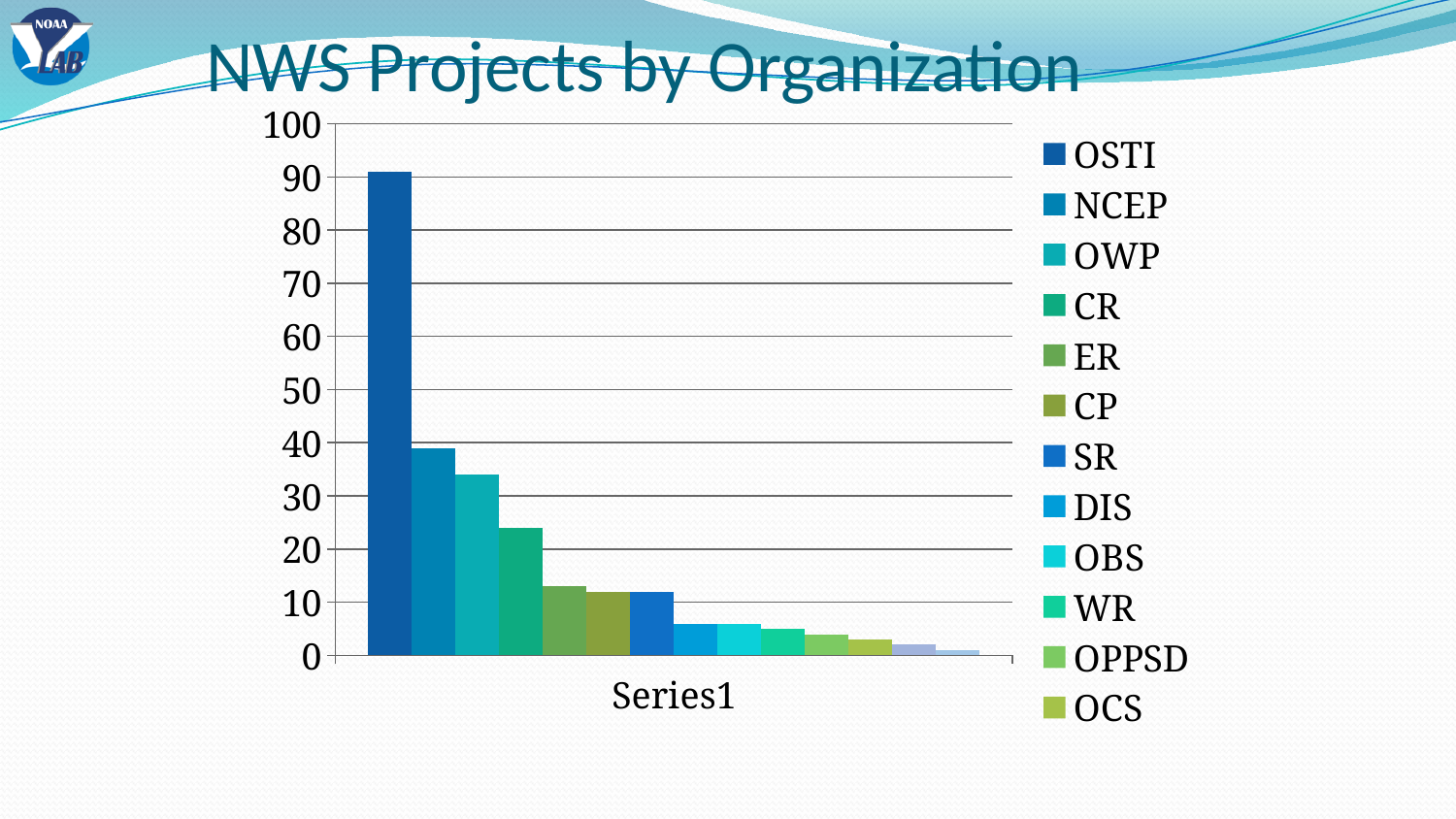
How many entries does the chart's legend list? 12 What kind of chart is shown on the slide? bar chart Is the value for OWP greater or less than 30? greater Is the value for DIS greater or less than 10? less Do the bar values rise or fall moving from left to right across the chart? fall Which organization has the highest number of projects? OSTI Which is larger, the value for OSTI or the value for NCEP? OSTI Is the value for OSTI greater or less than 80? greater What is the title of the chart? NWS Projects by Organization Which is larger, the value for CR or the value for ER? CR